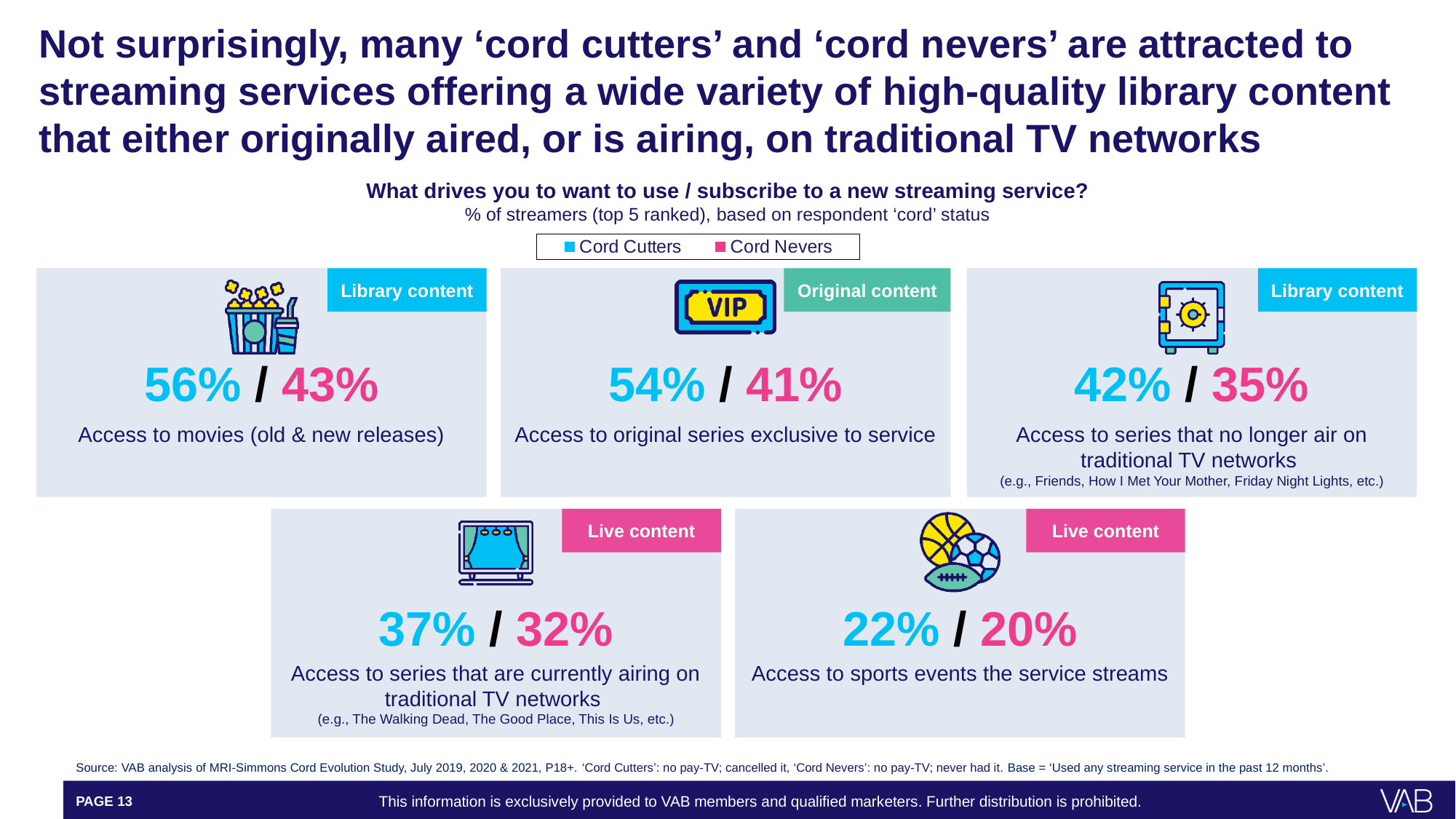
What is the difference between the Cord Cutters and Cord Nevers values for access to movies (old & new releases)? 13 percentage points Which driver has the lowest percentage among Cord Nevers? Access to sports events the service streams How many drivers (categories) are shown on the slide? 5 How many groups does the legend list? 2 What is the Cord Nevers value for access to sports events the service streams? 20% What percentage of Cord Nevers cite access to original series exclusive to service as a driver? 41% What is the Cord Cutters value for access to series that are currently airing on traditional TV networks? 37% What percentage of Cord Cutters say access to movies (old & new releases) drives them to subscribe to a new streaming service? 56% Which driver has the highest percentage among Cord Cutters? Access to movies (old & new releases) What is the difference between the Cord Cutters and Cord Nevers values for access to series that no longer air on traditional TV networks? 7 percentage points For access to original series exclusive to service, which group has the larger value, Cord Cutters or Cord Nevers? Cord Cutters Which content type label is attached to the 'Access to sports events the service streams' box? Live content